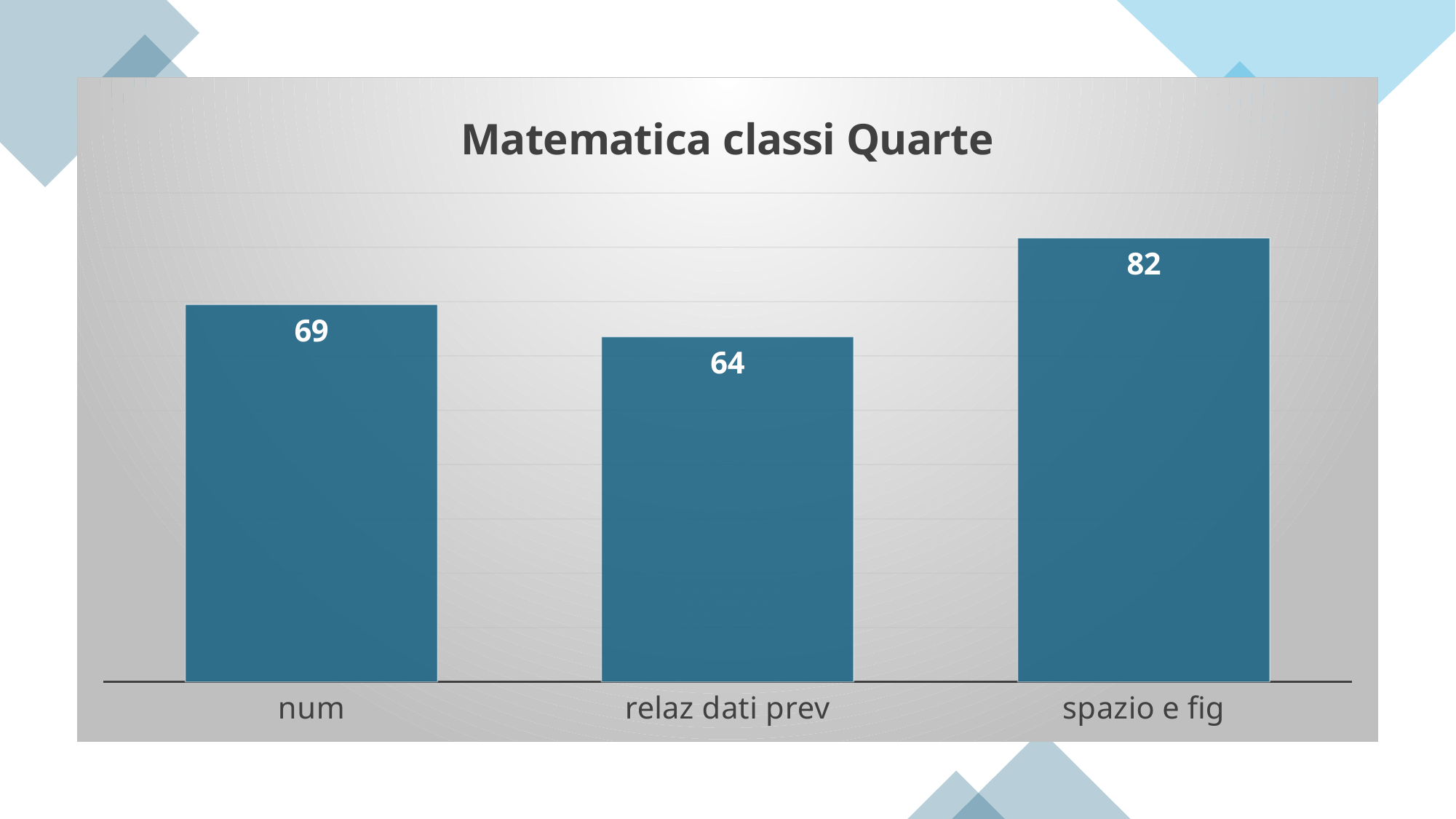
Which is larger, the value for num or the value for relaz dati prev? num What is the value for relaz dati prev? 64 What is the difference between the values for num and relaz dati prev? 5 What is the title of the chart? Matematica classi Quarte What is the value for spazio e fig? 82 What is the value for num? 69 What kind of chart is this? bar chart What is the total of the three values shown? 215 Which category has the highest value? spazio e fig How many categories are shown in the chart? 3 Which category has the lowest value? relaz dati prev What is the difference between the values for spazio e fig and num? 13